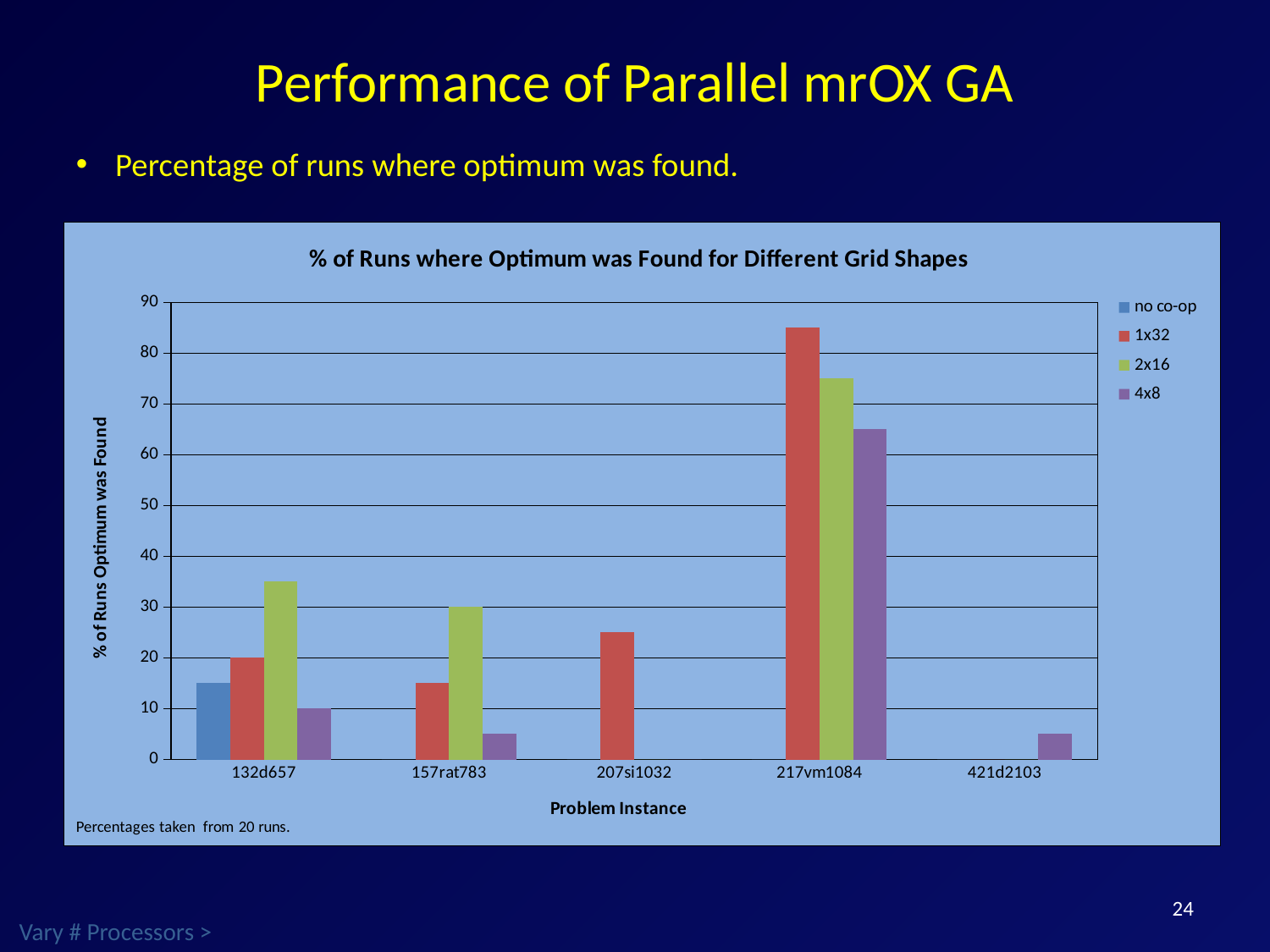
Which series is the only one with a visible bar for problem instance 421d2103? 4x8 How many series does the legend list? 4 How many problem instances are shown on the x axis? 5 What is the value for the 1x32 series on problem instance 132d657? 20 What kind of chart is shown on the slide? bar chart What is the value for the 4x8 series on problem instance 132d657? 10 Is the value for the 1x32 series on 217vm1084 greater or less than 80? greater Which problem instance has the highest value for the 1x32 series? 217vm1084 Is the value for the 4x8 series on 157rat783 greater or less than 10? less What is the title of the chart? % of Runs where Optimum was Found for Different Grid Shapes What is the value for the 2x16 series on problem instance 157rat783? 30 For problem instance 217vm1084, which series has the larger value, 2x16 or 4x8? 2x16